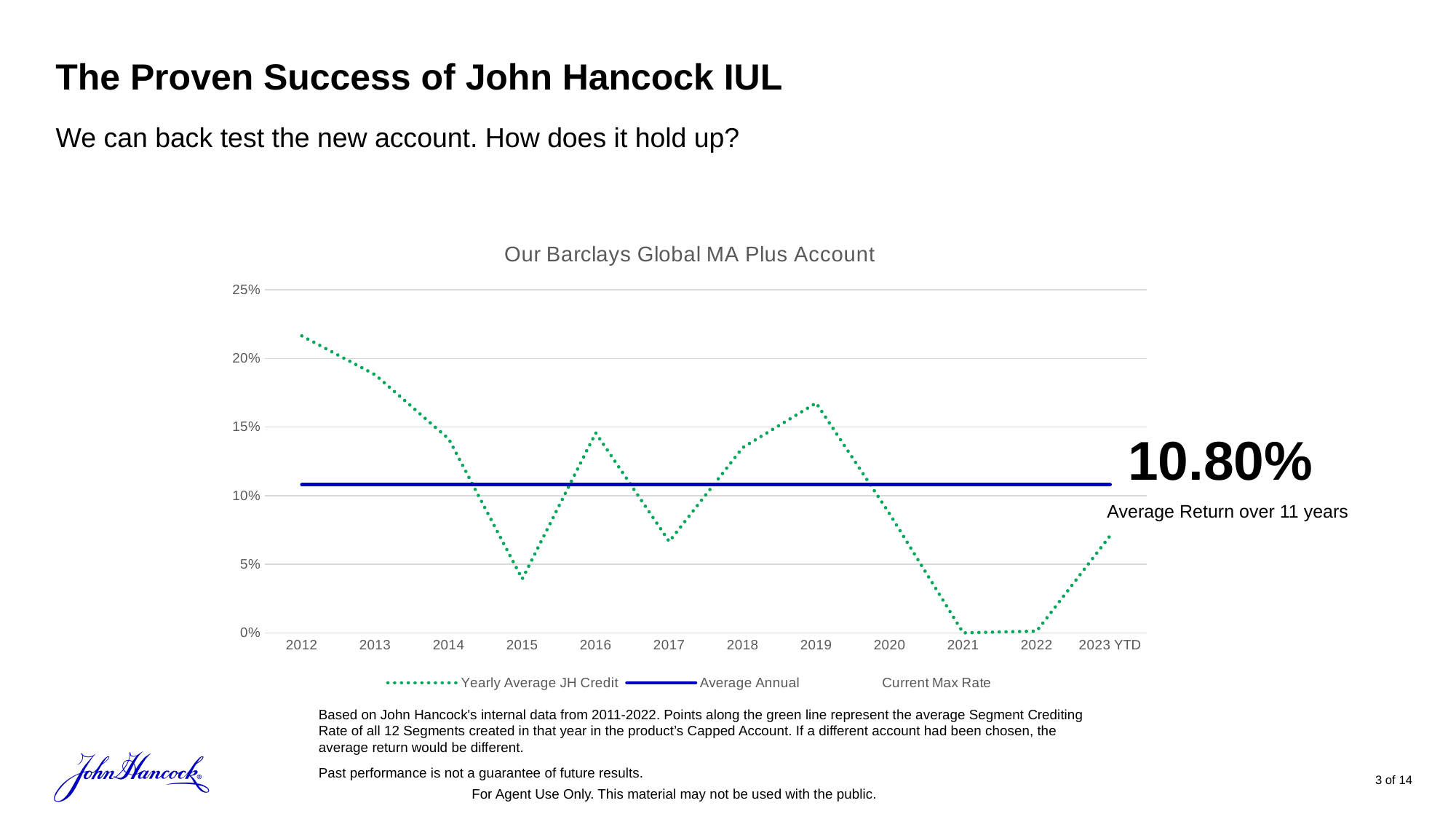
Is the Yearly Average JH Credit for 2019 greater or less than 15%? greater In which year is the Yearly Average JH Credit highest? 2012 Is the Yearly Average JH Credit for 2017 greater or less than 10%? less Does the Yearly Average JH Credit rise or fall from 2012 to 2015? fall What value is shown for the Average Return over 11 years? 10.80% Is the Yearly Average JH Credit for 2012 greater or less than 20%? greater What is the title of the chart? Our Barclays Global MA Plus Account How many series does the chart legend list? 3 How many years (categories) are shown along the x axis? 12 Which year has the larger Yearly Average JH Credit, 2016 or 2017? 2016 What kind of chart is shown on the slide? line chart